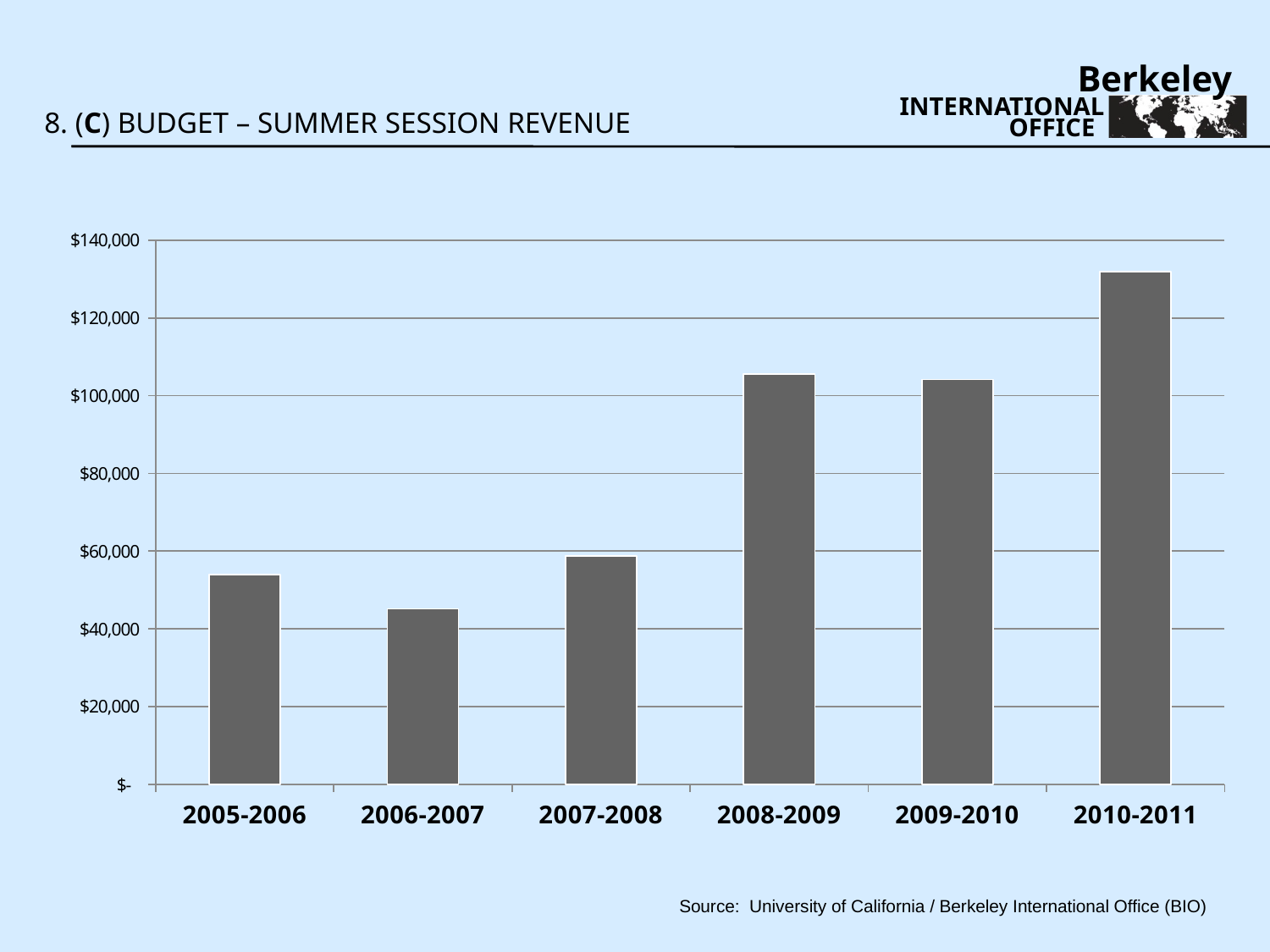
Which is larger, the value for 2005-2006 or the value for 2006-2007? 2005-2006 Which is larger, the value for 2009-2010 or the value for 2010-2011? 2010-2011 Is the value for 2006-2007 greater or less than $60,000? less How many academic years are shown on the x axis of the chart? 6 What is the title of the slide containing the chart? 8. (C) BUDGET – SUMMER SESSION REVENUE Is the value for 2008-2009 greater or less than $100,000? greater What kind of chart is shown on the slide? bar chart Which academic year has the highest summer session revenue? 2010-2011 Is the value for 2005-2006 greater or less than $40,000? greater Which academic year has the lowest summer session revenue? 2006-2007